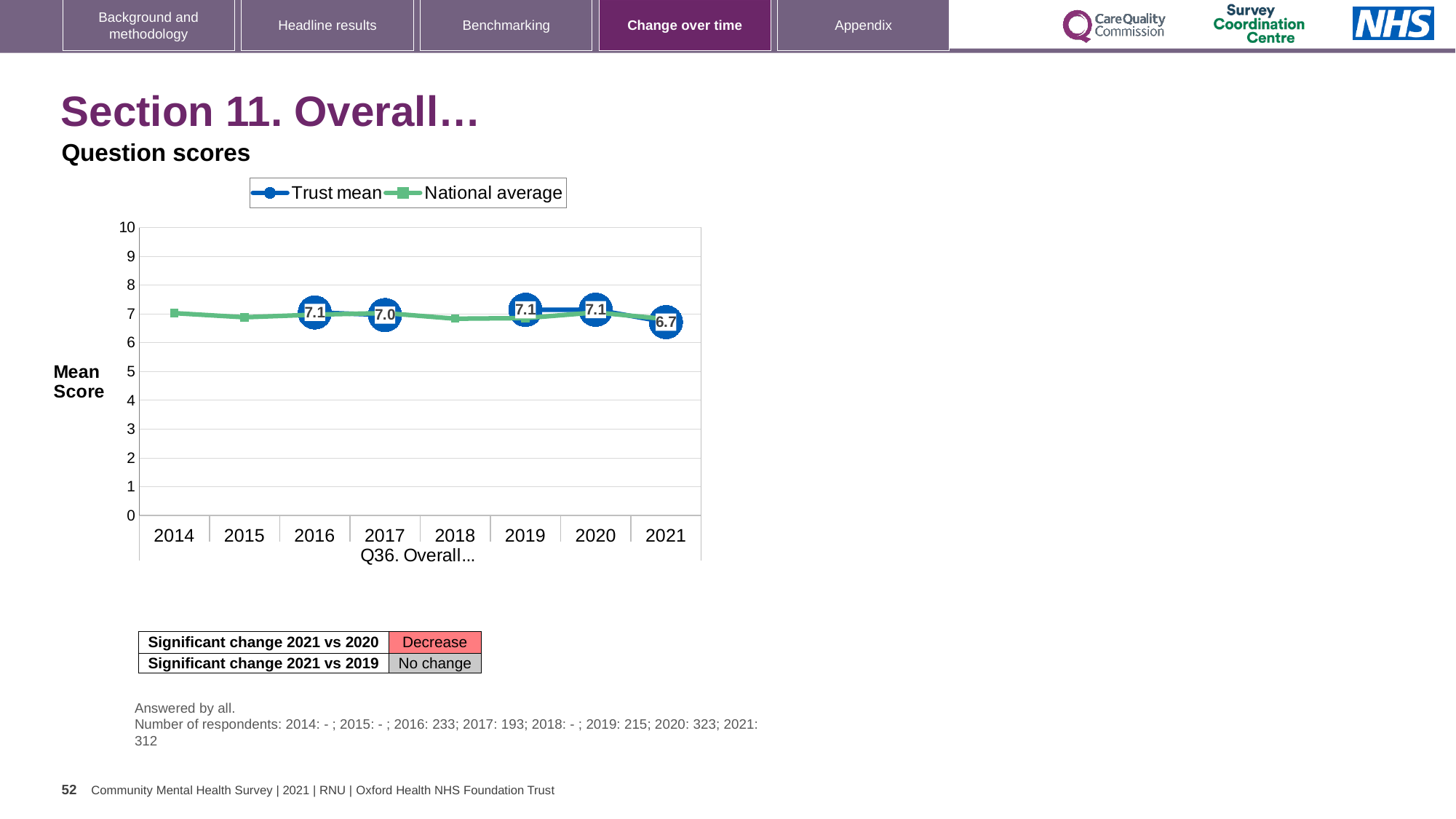
What is the difference between the Trust mean scores for 2020 and 2021? 0.4 Which year has the higher Trust mean score, 2016 or 2021? 2016 What is the Trust mean score for 2016? 7.1 What kind of chart is shown on the slide? Line chart Does the Trust mean score rise or fall from 2020 to 2021? Fall What is the Trust mean score for 2021? 6.7 In which year is the labelled Trust mean score lowest? 2021 How many years are shown on the x axis of the chart? 8 What is the Trust mean score for 2017? 7.0 How many series does the chart legend list? 2 Is the National average value for 2018 greater or less than 8? less Is the National average value for 2014 greater or less than 5? greater